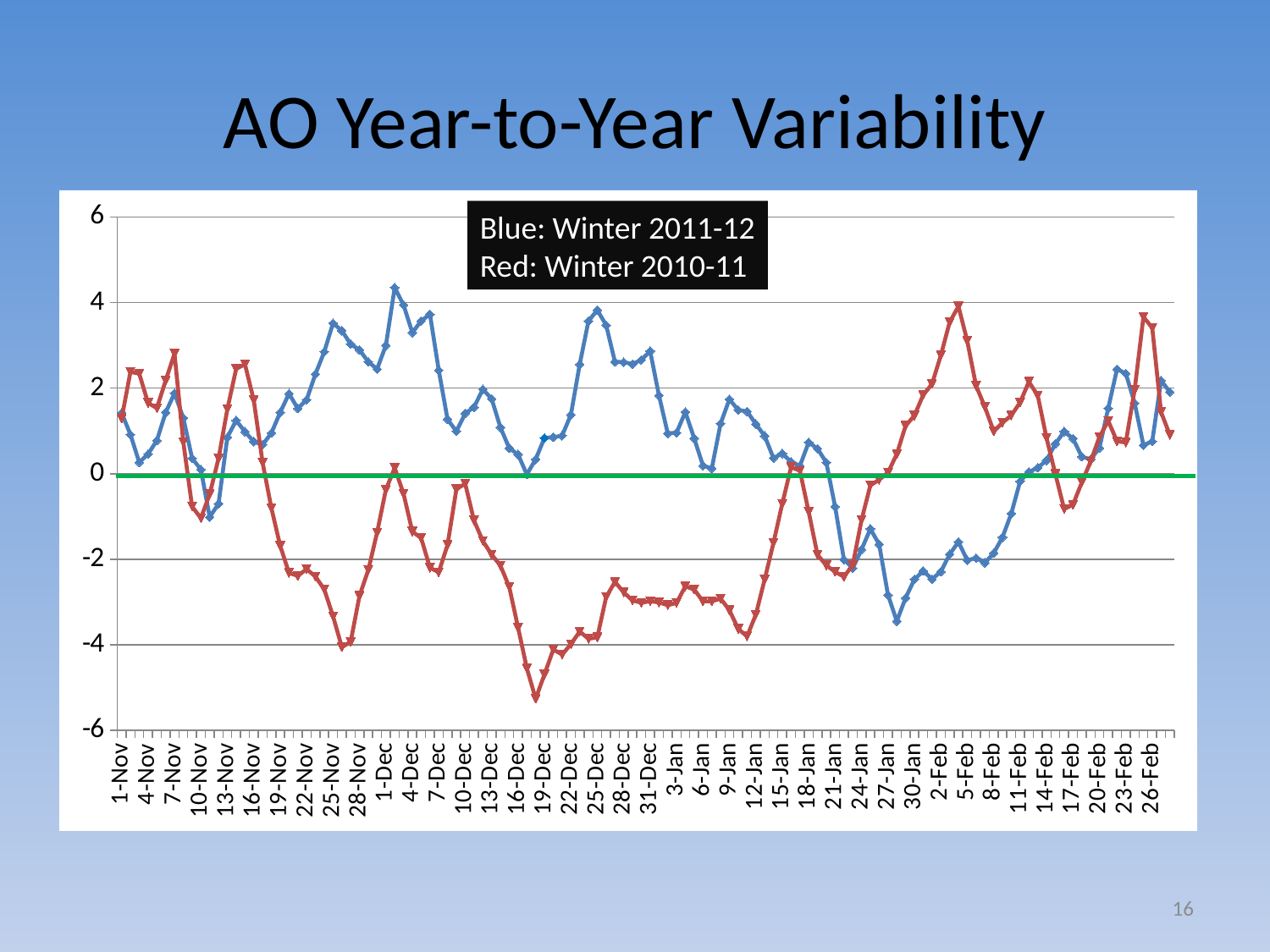
Is the peak value of the blue line (Winter 2011-12) around 1-Dec greater or less than 4? greater What is the title of the chart on the slide? AO Year-to-Year Variability How many data series are plotted on the chart? 2 Is the value of the red line (Winter 2010-11) around 19-Dec greater or less than -4? less Which series reaches the lowest value anywhere on the chart? red (Winter 2010-11) Which winter does the red line represent? Winter 2010-11 Around 5-Feb, which series has the higher value, blue (Winter 2011-12) or red (Winter 2010-11)? red (Winter 2010-11) Is the value of the blue line (Winter 2011-12) around 27-Jan greater or less than -2? less Does the red line (Winter 2010-11) generally rise or fall between 13-Nov and 25-Nov? fall What kind of chart is shown on the slide? line chart Around 19-Dec, which series has the higher value, blue (Winter 2011-12) or red (Winter 2010-11)? blue (Winter 2011-12)